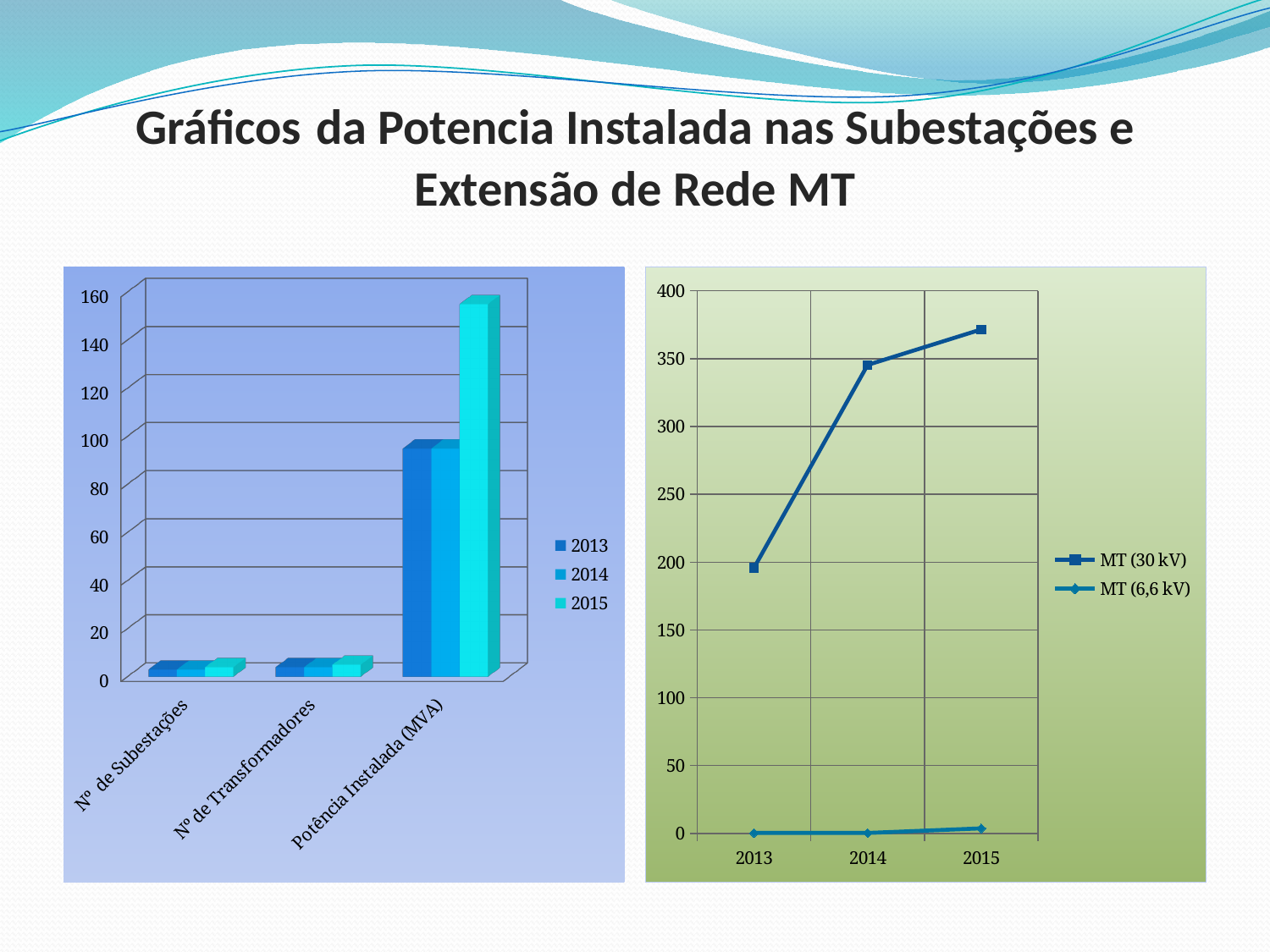
In the right chart, which series has the larger value in 2014, MT (30 kV) or MT (6,6 kV)? MT (30 kV) In the right chart, is the MT (30 kV) value for 2013 greater or less than 250? less How many categories are shown on the x axis of the left chart? 3 In the left chart, which year has the highest value for Potência Instalada (MVA)? 2015 In the left chart, is the 2015 value for Potência Instalada (MVA) greater or less than 140? greater In the right chart, does the MT (30 kV) series rise or fall from 2013 to 2015? rises In the left chart, is the 2013 value for Potência Instalada (MVA) greater or less than 80? greater How many series does the legend of the right chart list? 2 What kind of chart is the chart on the right of the slide? line chart How many series does the legend of the left chart list? 3 In the left chart, which category has the highest bars? Potência Instalada (MVA) What kind of chart is the chart on the left of the slide? bar chart